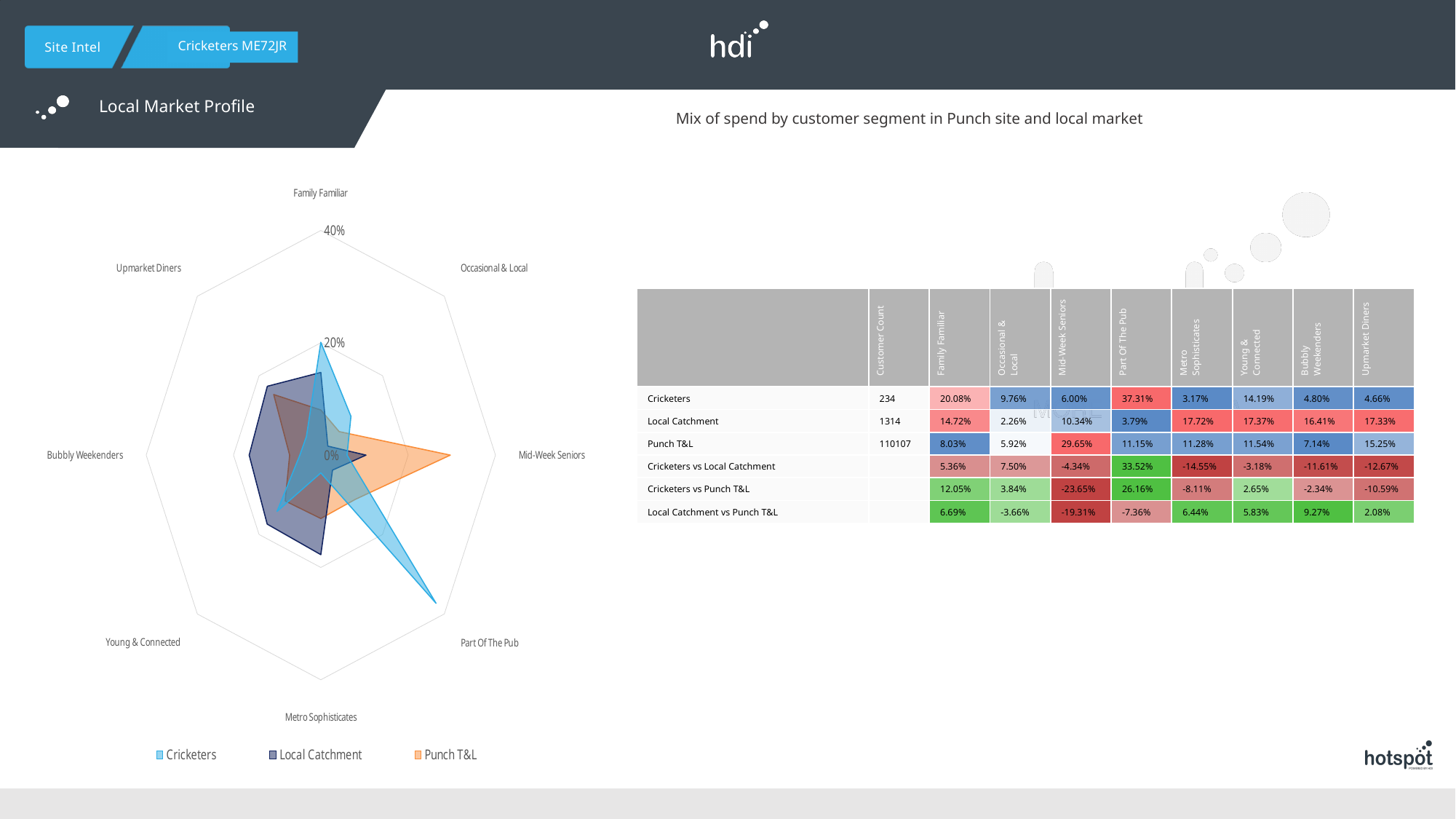
According to the table, what is the Punch T&L value for Mid-Week Seniors? 29.65% Which customer segment has the highest value for the Punch T&L series? Mid-Week Seniors What colour represents the Punch T&L series in the radar chart legend? Orange Which customer segment has the highest value for the Cricketers series? Part Of The Pub Which customer segment has the lowest value for the Cricketers series? Metro Sophisticates According to the table, what is the Cricketers value for Part Of The Pub? 37.31% Is the Local Catchment value for Bubbly Weekenders greater or less than 20%? less Which is larger for Family Familiar: the Cricketers value or the Local Catchment value? Cricketers How many series does the radar chart's legend list? 3 Is the Cricketers value for Part Of The Pub greater or less than 20%? greater How many customer segment categories are plotted on the radar chart? 8 What kind of chart is shown on the left of the slide? Radar chart